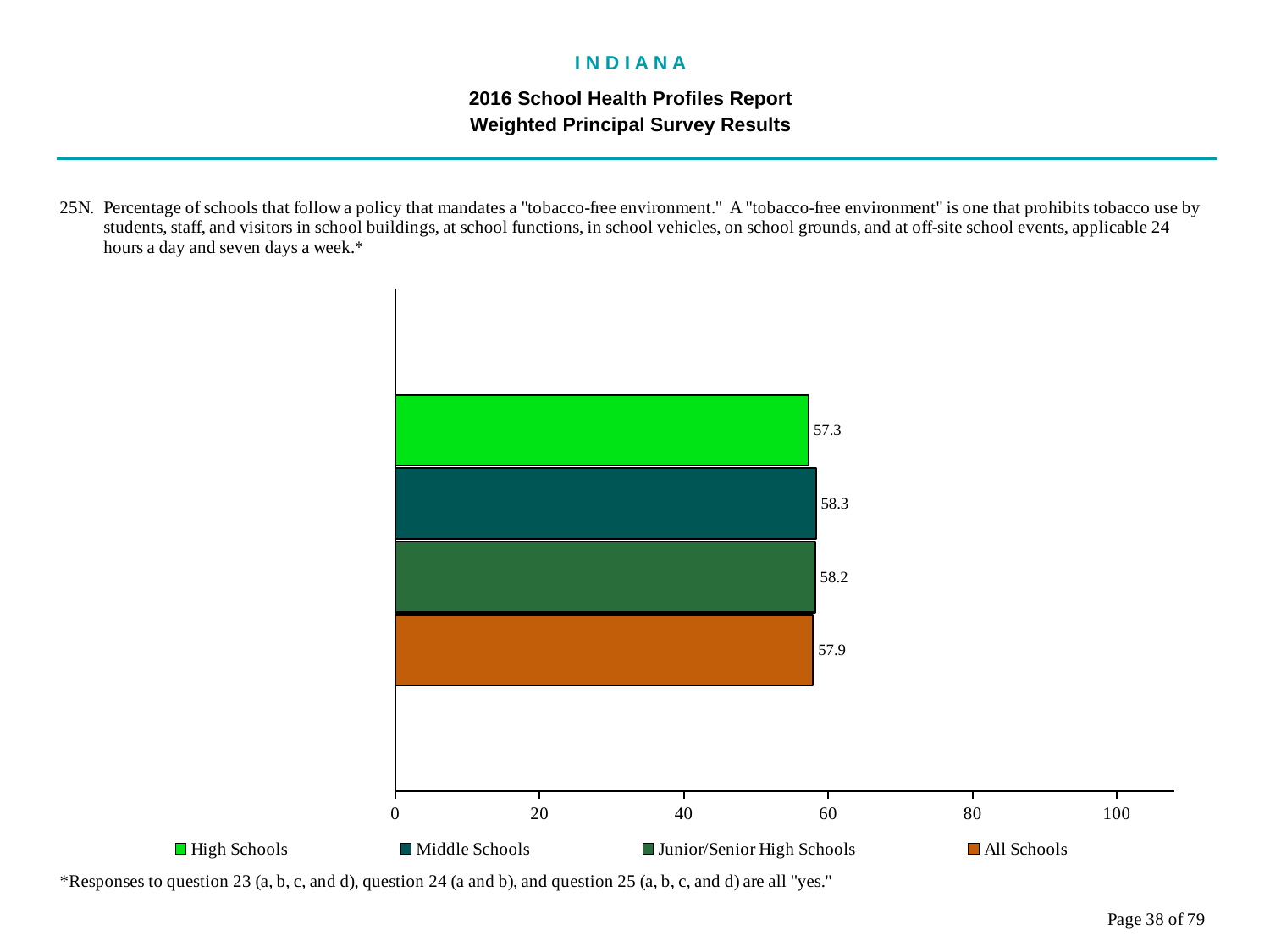
What is the value for Junior/Senior High Schools? 58.2 What is the value for Middle Schools? 58.3 What is the value for All Schools? 57.9 How many bars are plotted in the chart? 4 What kind of chart is shown on the slide? bar chart Is the value for All Schools greater or less than 60? less What is the value for High Schools? 57.3 Which school category has the highest value? Middle Schools Which is larger, the value for Junior/Senior High Schools or the value for All Schools? Junior/Senior High Schools What is the difference between the values for Middle Schools and High Schools? 1.0 How many entries does the legend list? 4 Which school category has the lowest value? High Schools